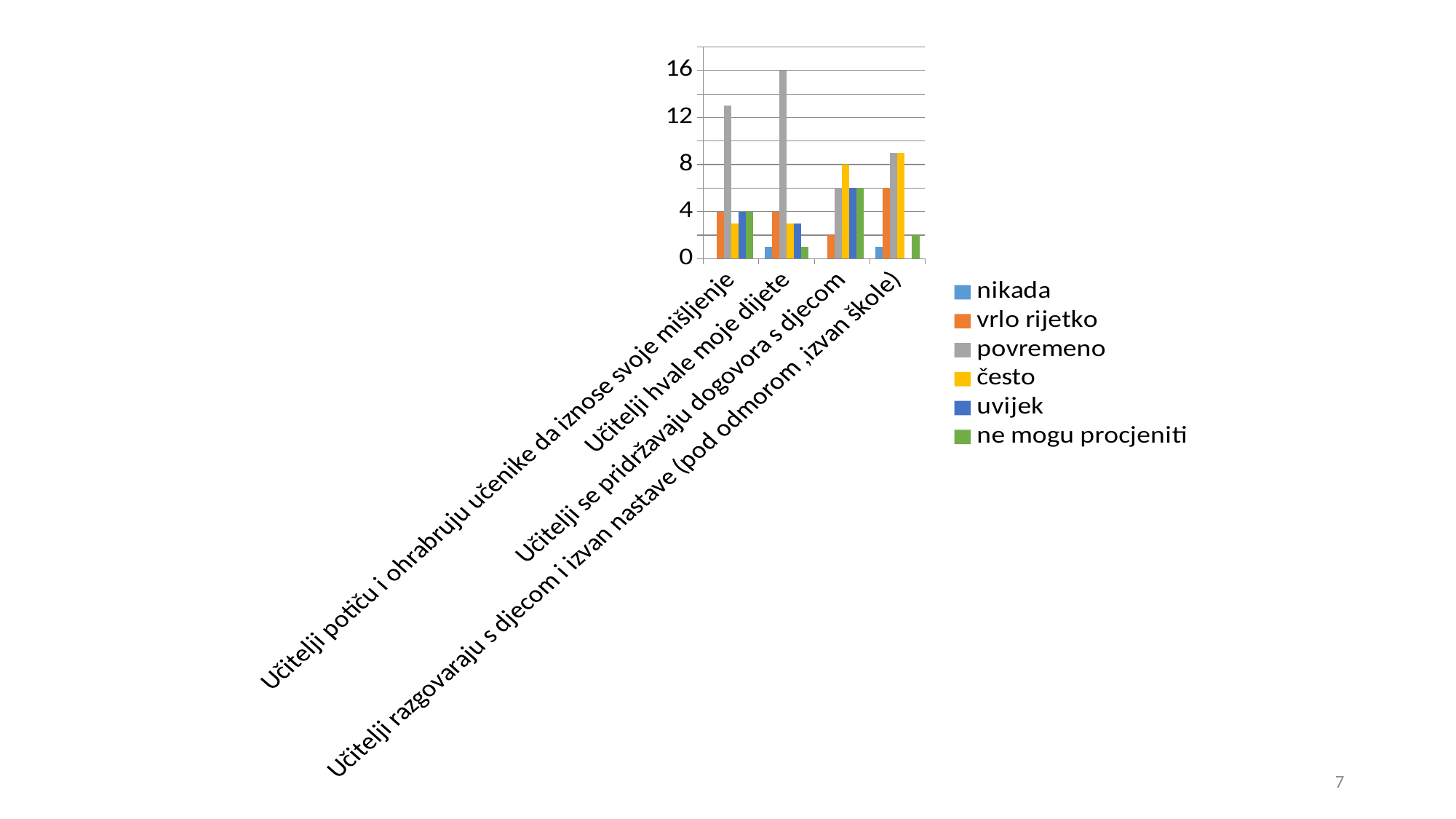
Which series is shown in green in the legend? ne mogu procjeniti What is the value of "često" for "Učitelji se pridržavaju dogovora s djecom"? 8 How many series does the legend list? 6 Is the value of "vrlo rijetko" for "Učitelji razgovaraju s djecom i izvan nastave (pod odmorom ,izvan škole)" greater or less than 4? greater What is the value of "povremeno" for "Učitelji hvale moje dijete"? 16 What is the value of "vrlo rijetko" for "Učitelji potiču i ohrabruju učenike da iznose svoje mišljenje"? 4 For which category is the "povremeno" bar the highest? Učitelji hvale moje dijete What kind of chart is shown on the slide? bar chart Which is larger for "Učitelji se pridržavaju dogovora s djecom": "često" or "vrlo rijetko"? često Which series has the tallest bar for "Učitelji potiču i ohrabruju učenike da iznose svoje mišljenje"? povremeno How many categories are shown on the x axis? 4 Is the value of "povremeno" for "Učitelji potiču i ohrabruju učenike da iznose svoje mišljenje" greater or less than 12? greater